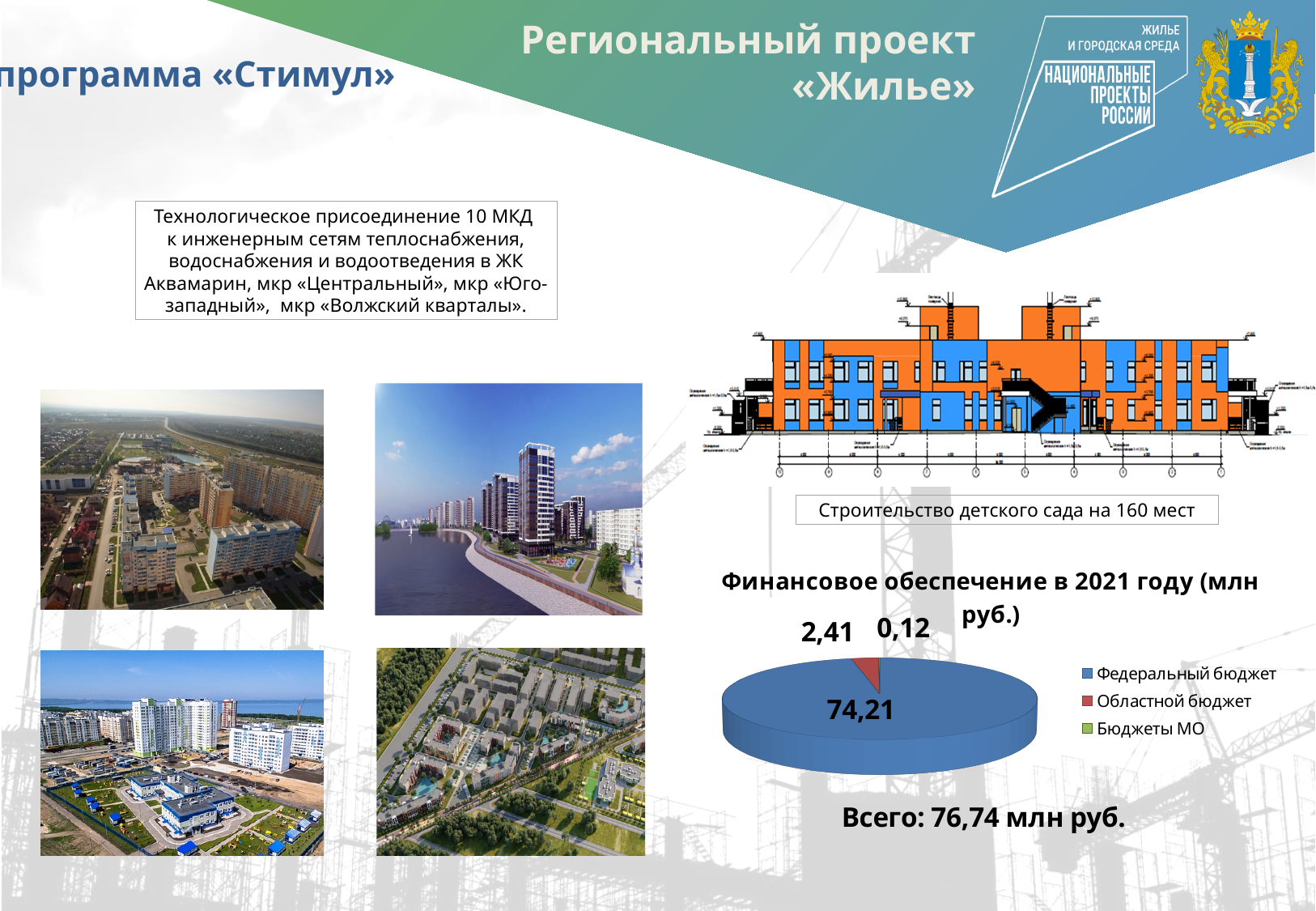
What is the difference between the values for «Федеральный бюджет» and «Областной бюджет» in the pie chart? 71,80 What is the difference between the values for «Областной бюджет» and «Бюджеты МО» in the pie chart? 2,29 What is the value for «Бюджеты МО» in the pie chart? 0,12 What is the value for «Федеральный бюджет» in the pie chart? 74,21 What is the title of the pie chart? Финансовое обеспечение в 2021 году (млн руб.) What is the value for «Областной бюджет» in the pie chart? 2,41 What total is stated below the pie chart? 76,74 млн руб. Which is larger in the pie chart: «Областной бюджет» or «Бюджеты МО»? Областной бюджет Which category has the largest slice in the pie chart? Федеральный бюджет Which category has the smallest slice in the pie chart? Бюджеты МО What kind of chart is shown under the title «Финансовое обеспечение в 2021 году (млн руб.)»? pie chart How many categories does the pie chart legend list? 3